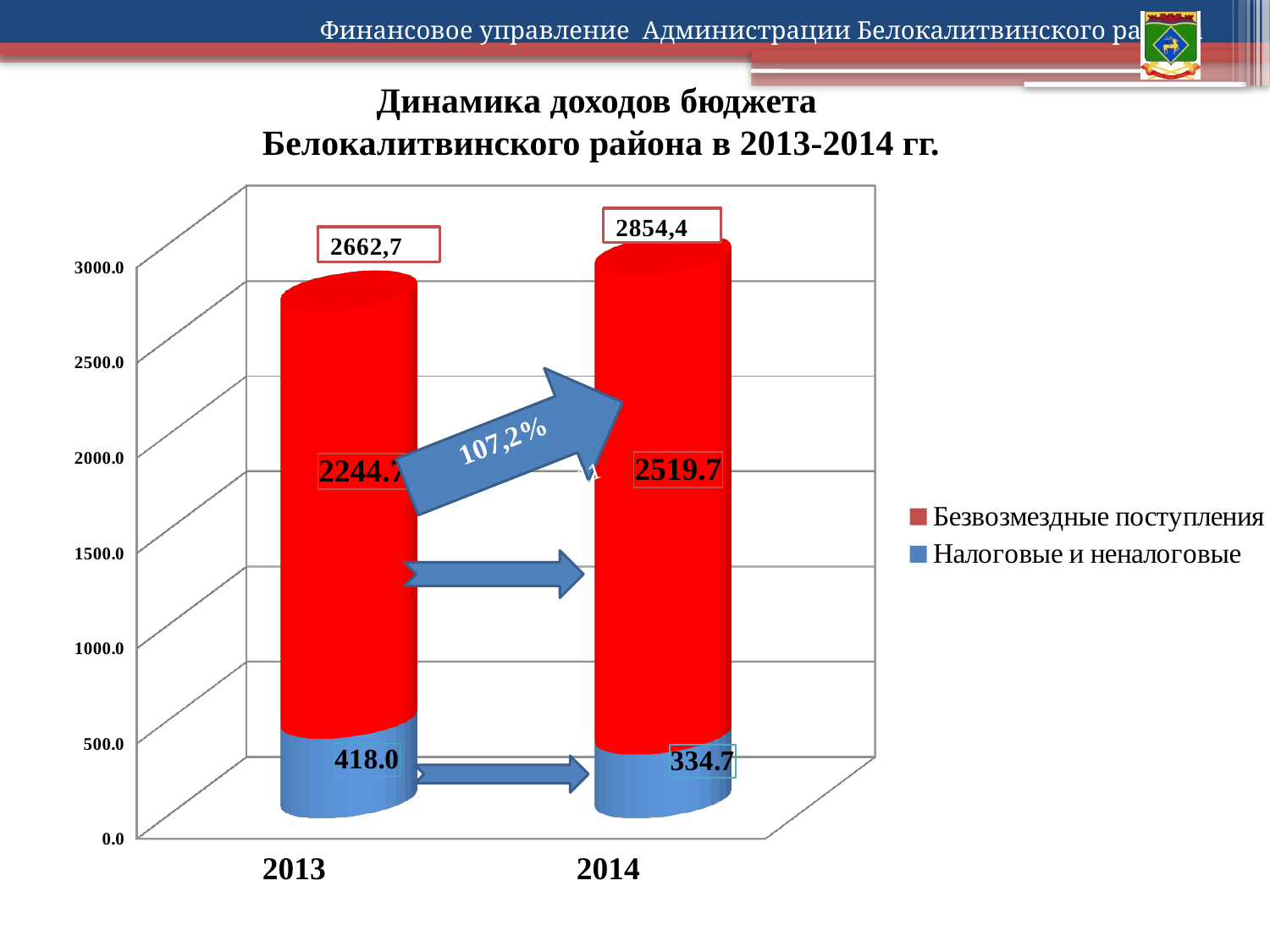
How many series does the legend list? 2 By how much did Налоговые и неналоговые decrease from 2013 to 2014? 83.3 What is the difference between the total for 2014 and the total for 2013? 191.7 What is the total of the stacked bar for 2013? 2662,7 What kind of chart is shown on the slide? Stacked bar chart What is the value of Налоговые и неналоговые for 2013? 418.0 What is the total of the stacked bar for 2014? 2854,4 What percentage is written on the large arrow between the two bars? 107,2% What is the value of Безвозмездные поступления for 2014? 2519.7 What is the value of Налоговые и неналоговые for 2014? 334.7 How many years are shown on the x axis? 2 Which year has the larger value for Налоговые и неналоговые, 2013 or 2014? 2013